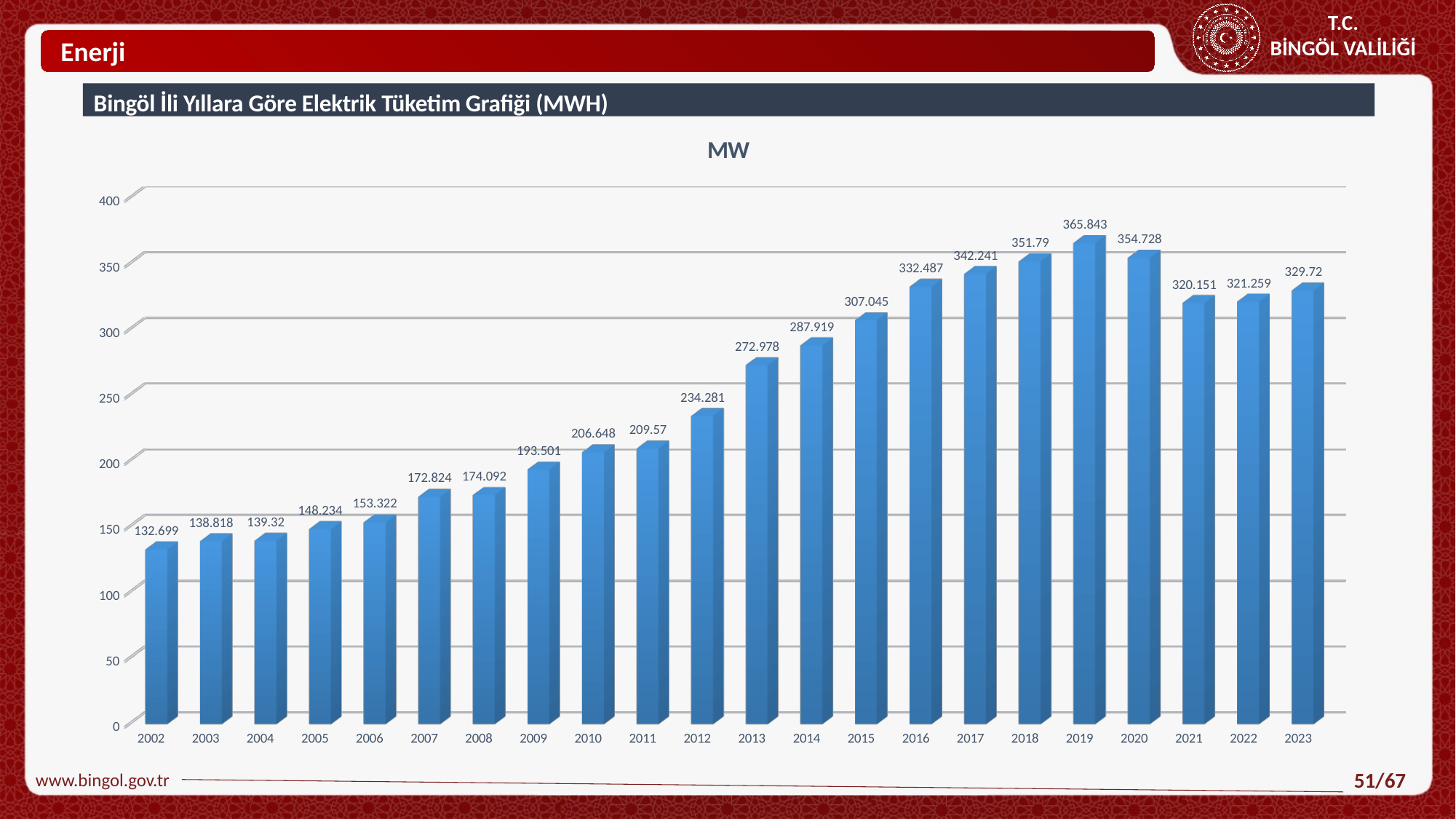
What is the difference between the values for 2019 and 2002? 233.144 Which year has the lowest value? 2002 What is the value for 2019? 365.843 How many years are shown on the x axis? 22 What is the value for 2023? 329.72 What kind of chart is shown? bar chart Do the values rise or fall from 2002 to 2019? rise Which year has the highest value? 2019 What is the value for 2002? 132.699 Is the value for 2015 greater or less than 300? greater Which is larger, the value for 2012 or the value for 2013? 2013 What is the difference between the values for 2020 and 2021? 34.577